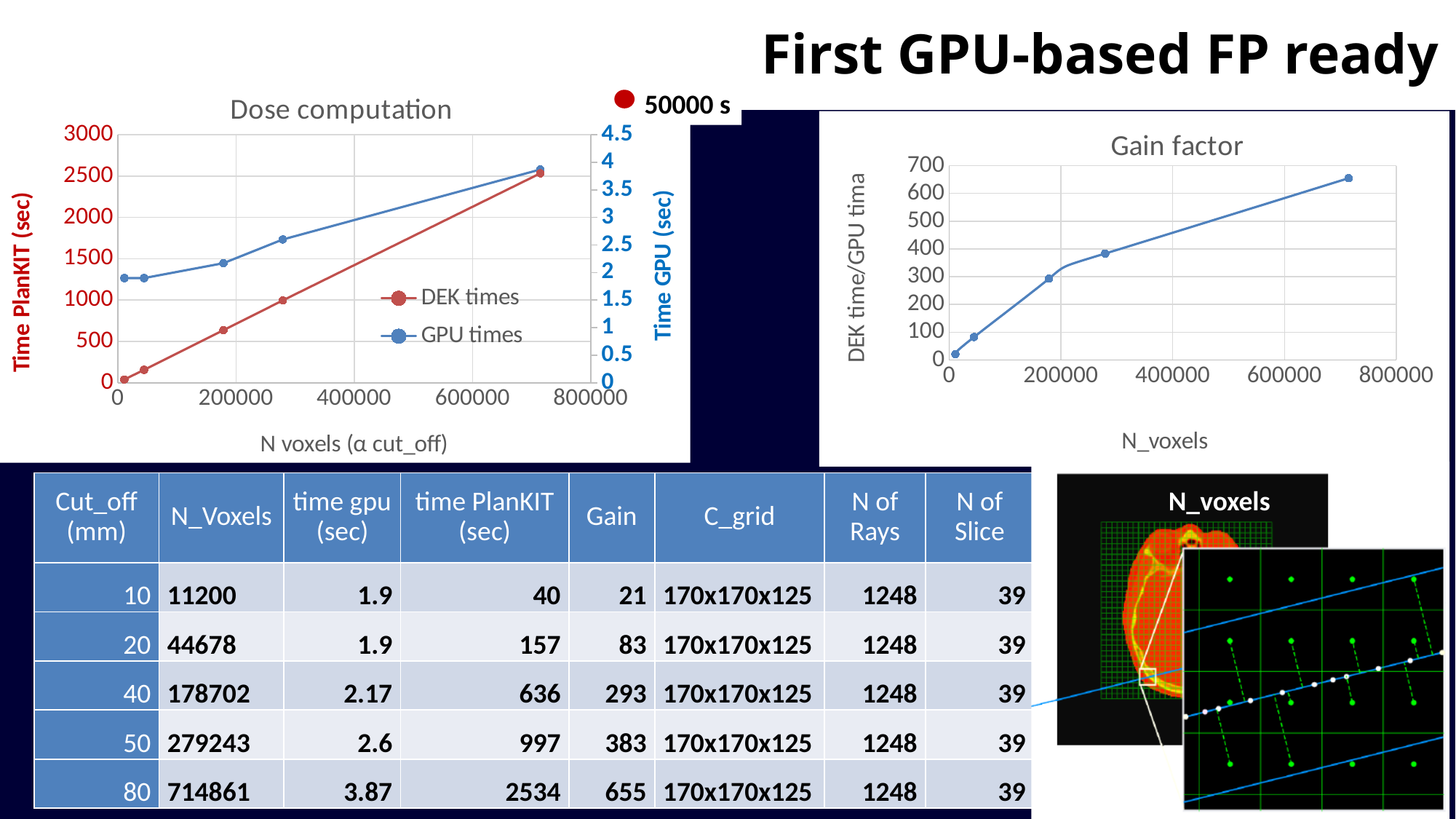
In the 'Dose computation' chart, is the GPU times value at the rightmost point (near 700000 voxels) greater or less than 3.5 seconds? greater In the 'Dose computation' chart, do the DEK times rise or fall as the number of voxels increases? rise How many series does the legend of the 'Dose computation' chart list? 2 In the 'Gain factor' chart, is the value of the rightmost point (near 700000 voxels) greater or less than 600? greater What is the x-axis label of the 'Gain factor' chart? N_voxels What kind of chart is the 'Dose computation' chart? line chart What are the two series named in the legend of the 'Dose computation' chart? DEK times and GPU times How many data points are plotted in the 'Gain factor' chart? 5 What kind of chart is the 'Gain factor' chart? line chart In the 'Gain factor' chart, does the gain factor rise or fall as N_voxels increases? rise How many data points does the GPU times series have in the 'Dose computation' chart? 5 In the 'Dose computation' chart, is the DEK times value at roughly 280000 voxels greater or less than 1500 seconds? less